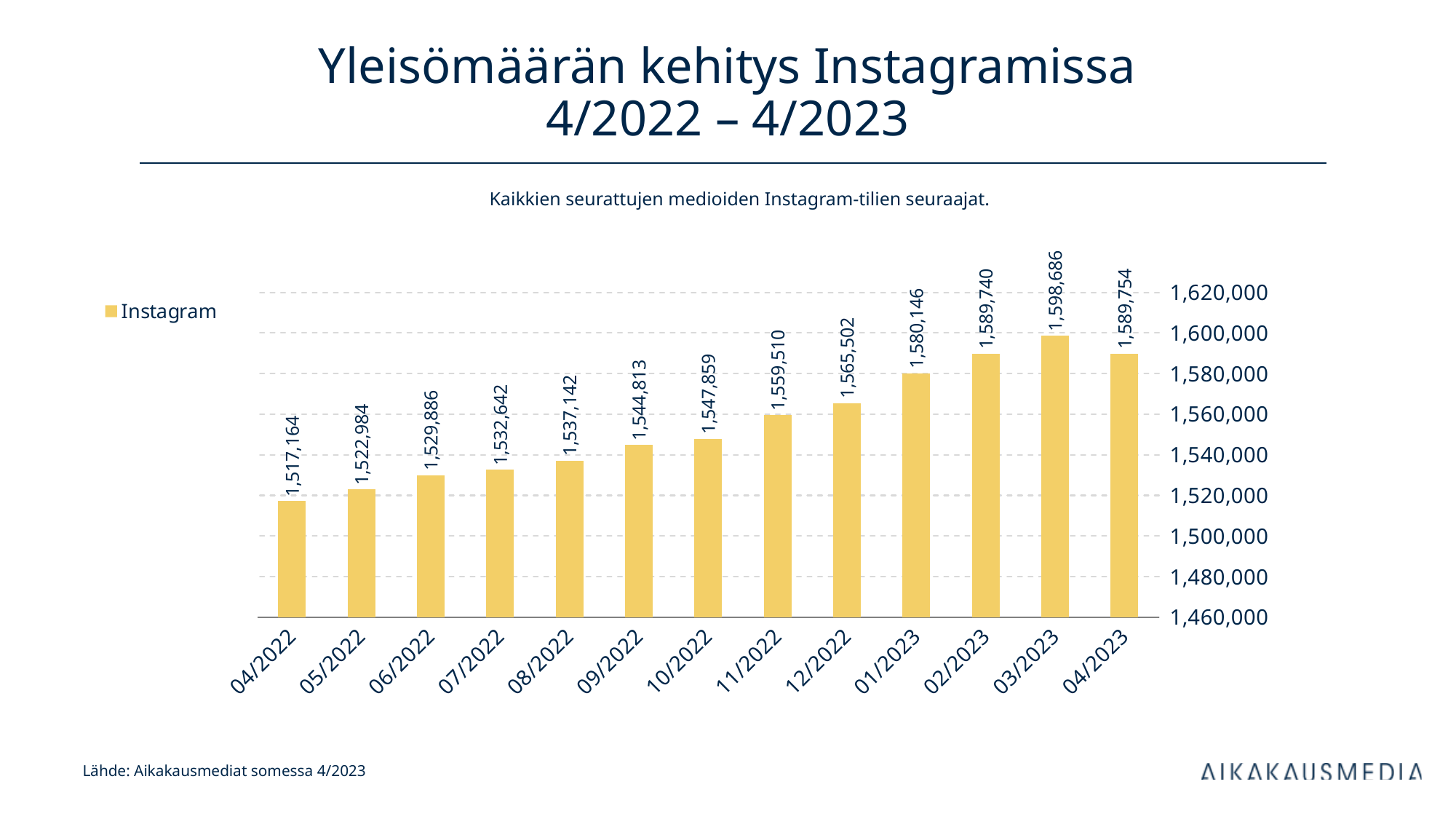
What is the value for 04/2022? 1,517,164 What is the value for 12/2022? 1,565,502 What kind of chart is shown on the slide? bar chart Which month has the lowest value? 04/2022 What is the difference between the values for 03/2023 and 04/2022? 81,522 Which is larger, the value for 01/2023 or the value for 09/2022? 01/2023 Is the value for 10/2022 greater or less than 1,560,000? less What is the value for 04/2023? 1,589,754 Which month has the highest value? 03/2023 What is the difference between the values for 04/2023 and 04/2022? 72,590 How many series does the legend list? 1 How many months are shown on the x axis? 13